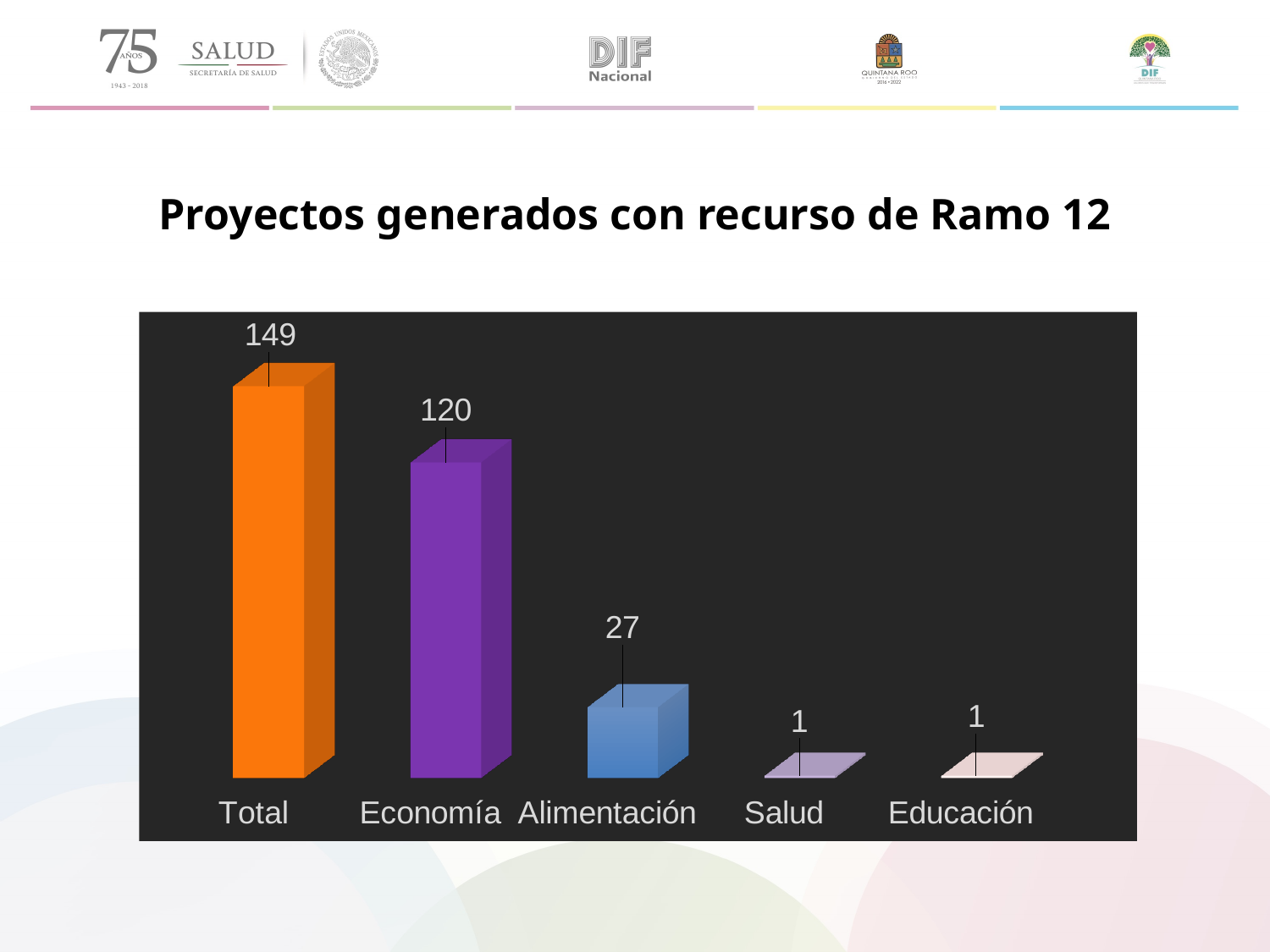
Which is larger, the value for Economía or the value for Alimentación? Economía Which category has the highest value? Total What kind of chart is shown on the slide? bar chart What is the value for Salud? 1 Do the values rise or fall from Total to Educación along the x axis? fall What is the title of the chart? Proyectos generados con recurso de Ramo 12 What is the difference between the values for Economía and Alimentación? 93 How many categories are shown on the x axis? 5 What is the difference between the values for Total and Economía? 29 What is the value for Total? 149 What is the value for Economía? 120 What is the value for Alimentación? 27